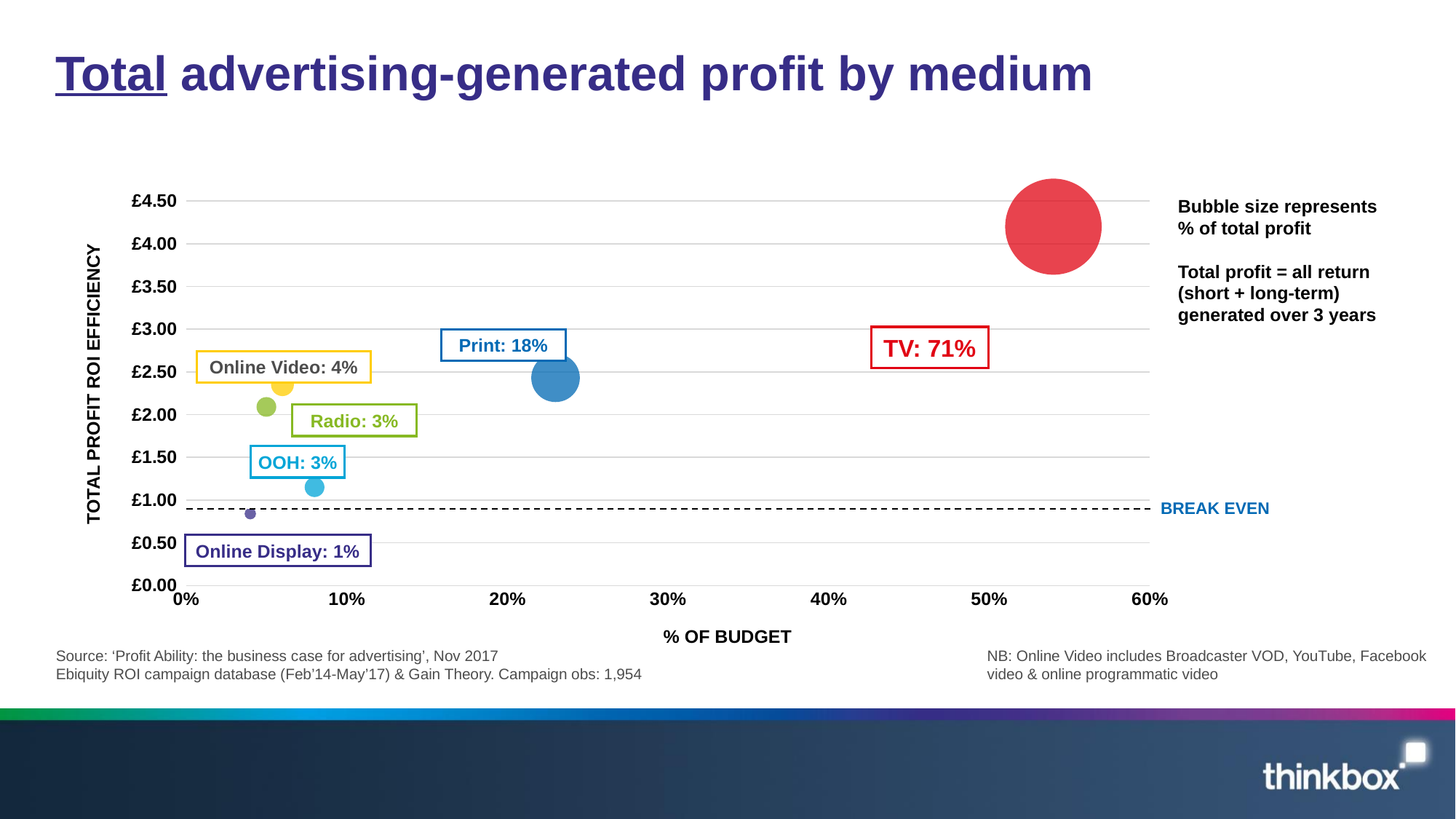
What percentage of total profit does TV account for? 71% What does the bubble size represent in the chart? % of total profit Which medium has the lowest total profit ROI efficiency? Online Display How many media are plotted on the chart? 6 What kind of chart is shown on the slide? Bubble chart Which has the higher total profit ROI efficiency, Print or OOH? Print Is the total profit ROI efficiency for Online Display greater or less than £1.00? less What percentage of total profit does Print account for? 18% Is the % of budget for TV greater or less than 50%? greater What is the difference between TV's and Print's share of total profit? 53% Which medium has the highest total profit ROI efficiency? TV Is the total profit ROI efficiency for TV greater or less than £4.00? greater